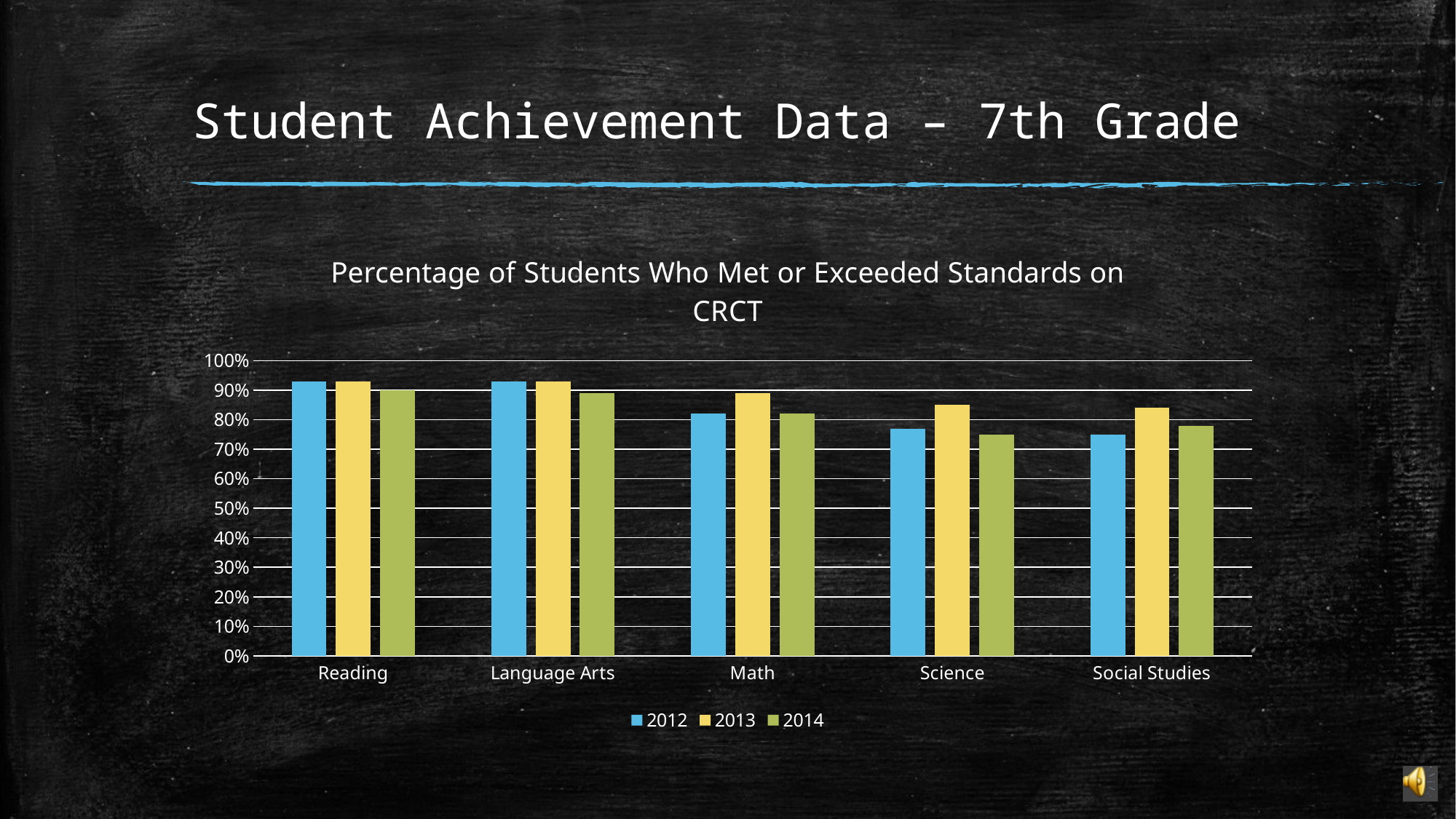
How many series does the legend list? 3 Is the value for Science in 2014 greater or less than 80%? less For Math, which year has the larger value, 2013 or 2014? 2013 How many subject categories are shown on the x axis? 5 Is the value for Social Studies in 2012 greater or less than 80%? less Is the value for Language Arts in 2014 greater or less than 80%? greater Do the 2012 values generally rise or fall moving from Reading to Social Studies along the x axis? fall For Science, which year has the larger value, 2012 or 2013? 2013 What is the title of the chart? Percentage of Students Who Met or Exceeded Standards on CRCT Which subject has the lowest value for 2014? Science What kind of chart is shown on the slide? bar chart